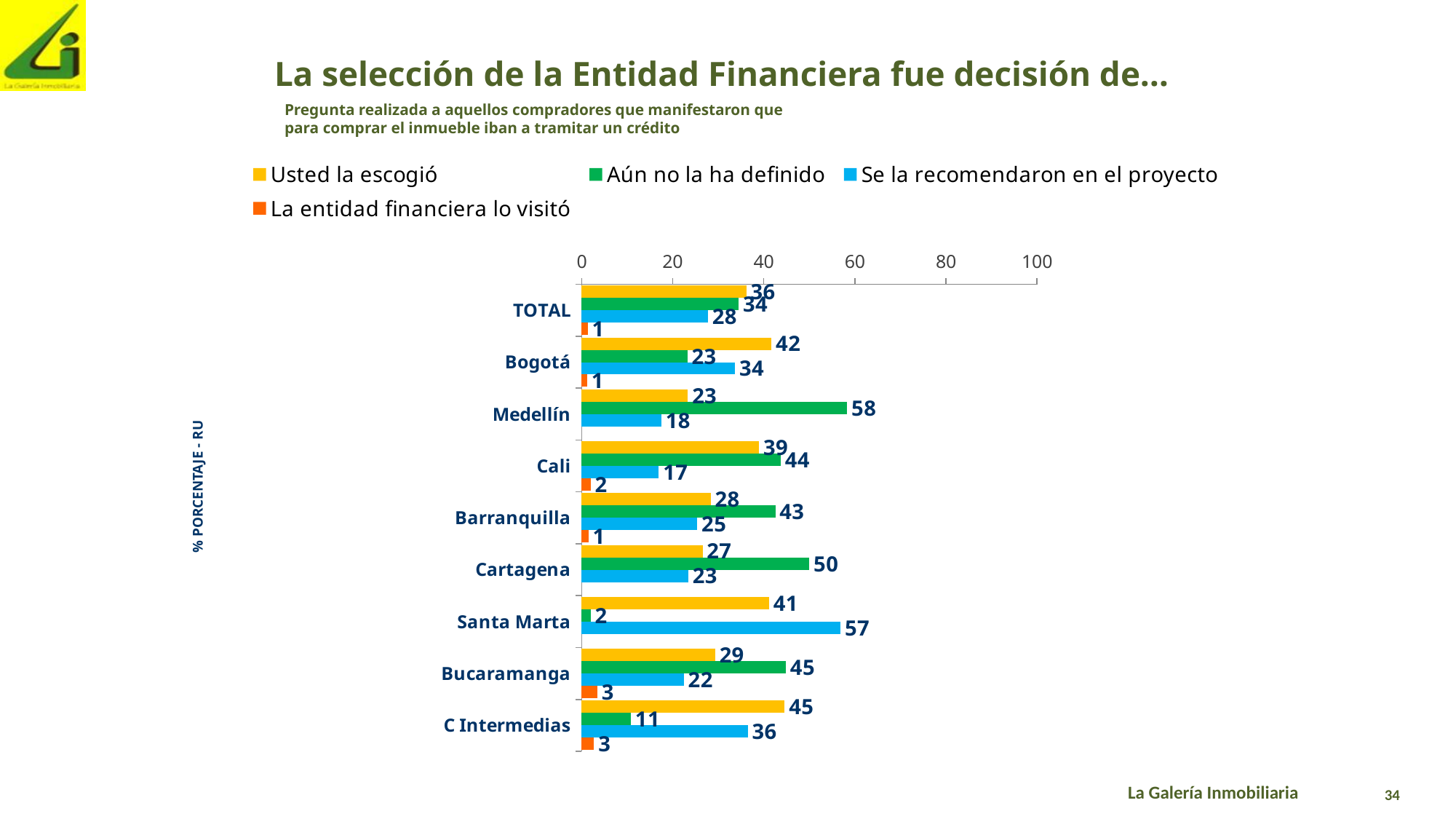
What is the value for "Usted la escogió" in Bogotá? 42 What is the value for "Aún no la ha definido" in Medellín? 58 How many categories are shown on the vertical axis of the chart? 9 What is the difference between "Usted la escogió" and "Aún no la ha definido" in C Intermedias? 34 In Cartagena, which is larger: "Usted la escogió" or "Aún no la ha definido"? Aún no la ha definido Is the value for "Aún no la ha definido" in Cali greater or less than 40? greater What is the value for "La entidad financiera lo visitó" in Bucaramanga? 3 What is the value for "Se la recomendaron en el proyecto" in Santa Marta? 57 What kind of chart is shown on the slide? Bar chart Which city has the highest value for "Aún no la ha definido"? Medellín Which category has the lowest value for "Se la recomendaron en el proyecto"? Cali How many series does the legend list? 4